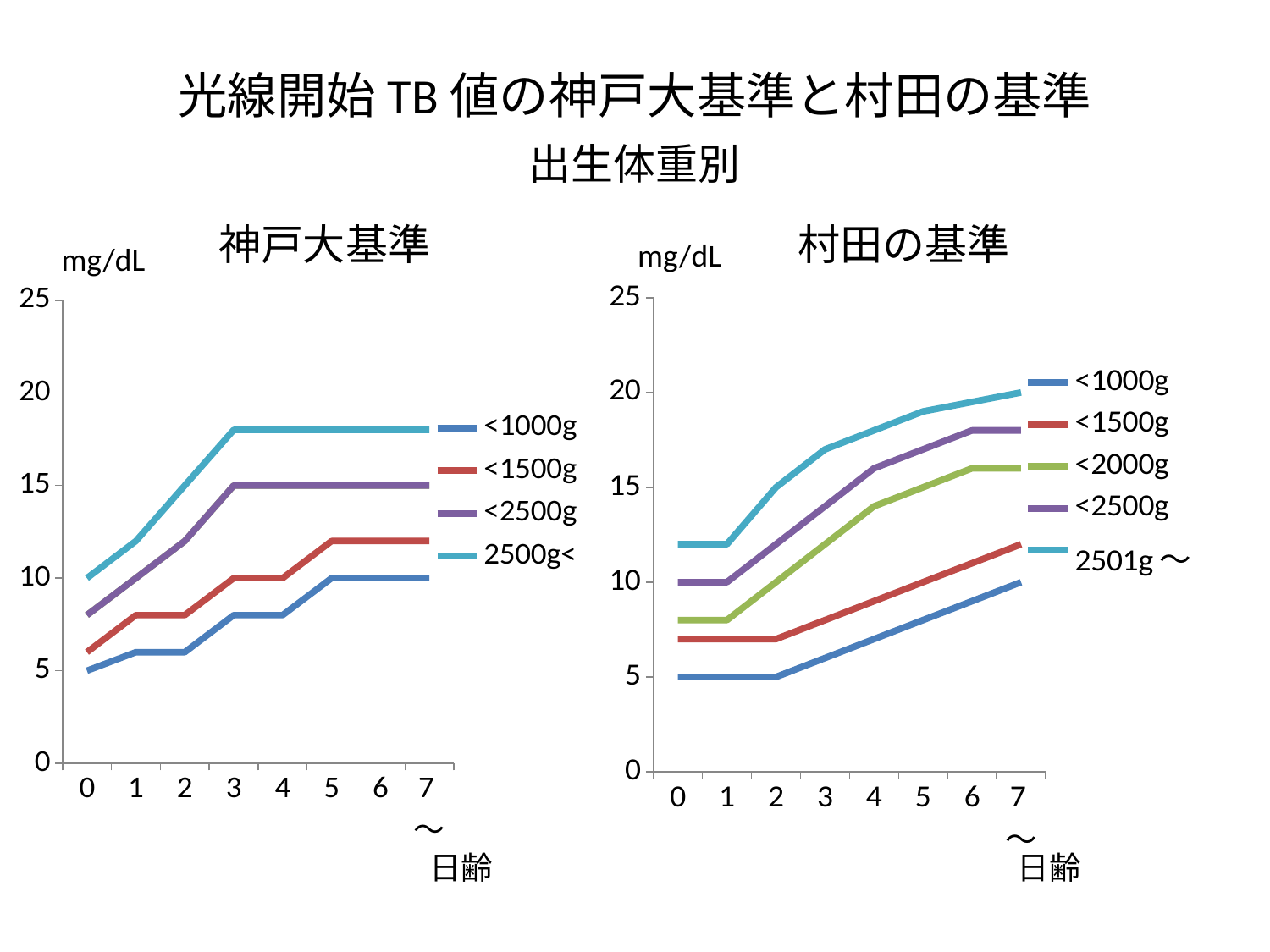
In the 村田の基準 chart, what is the value for 2501g～ at day 7? 20 In the 村田の基準 chart, what is the value for <1000g at day 7? 10 In the 村田の基準 chart, which series has the highest values? 2501g～ How many series does the legend of the 神戸大基準 chart list? 4 In the 神戸大基準 chart, what is the value for 2500g< at day 0? 10 In the 神戸大基準 chart, do the values for <1500g rise or fall from day 0 to day 7? rise In the 村田の基準 chart, is the value for <2000g at day 7 greater or less than 15? greater How many series does the legend of the 村田の基準 chart list? 5 In the 神戸大基準 chart, what is the value for <2500g at day 7? 15 What kind of chart is the 神戸大基準 chart? line chart In the 神戸大基準 chart, what is the value for <1000g at day 0? 5 In the 神戸大基準 chart, is the value for 2500g< at day 7 greater or less than 15? greater